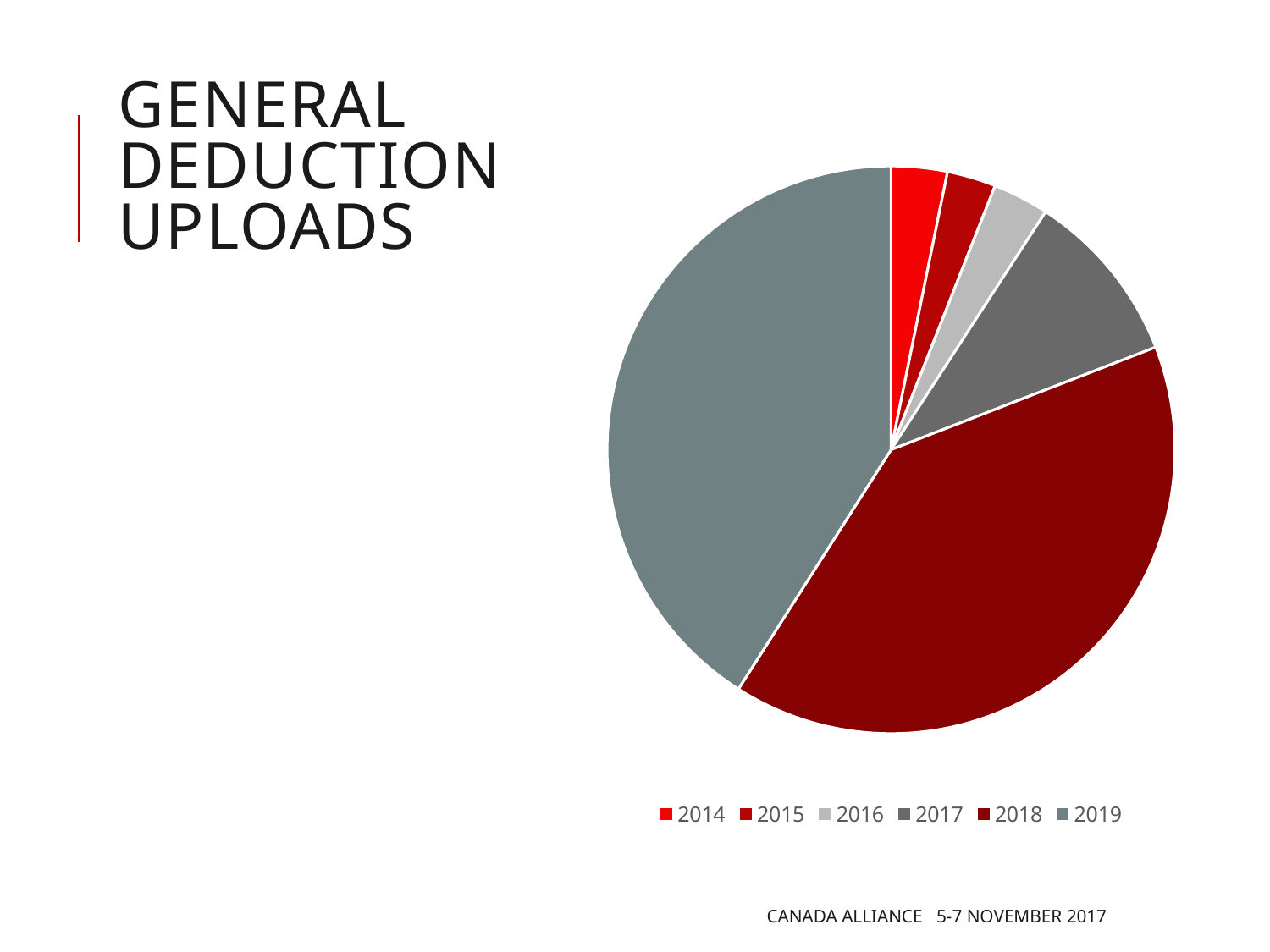
Which year is the first entry listed in the pie chart's legend? 2014 Which slice is larger in the pie chart, 2018 or 2016? 2018 What kind of chart is shown on the slide? Pie chart Which slice is larger in the pie chart, 2018 or 2017? 2018 Which slice is larger in the pie chart, 2017 or 2016? 2017 How many slices does the pie chart have? 6 How many entries does the legend of the pie chart list? 6 What is the title of the slide containing the pie chart? General Deduction Uploads